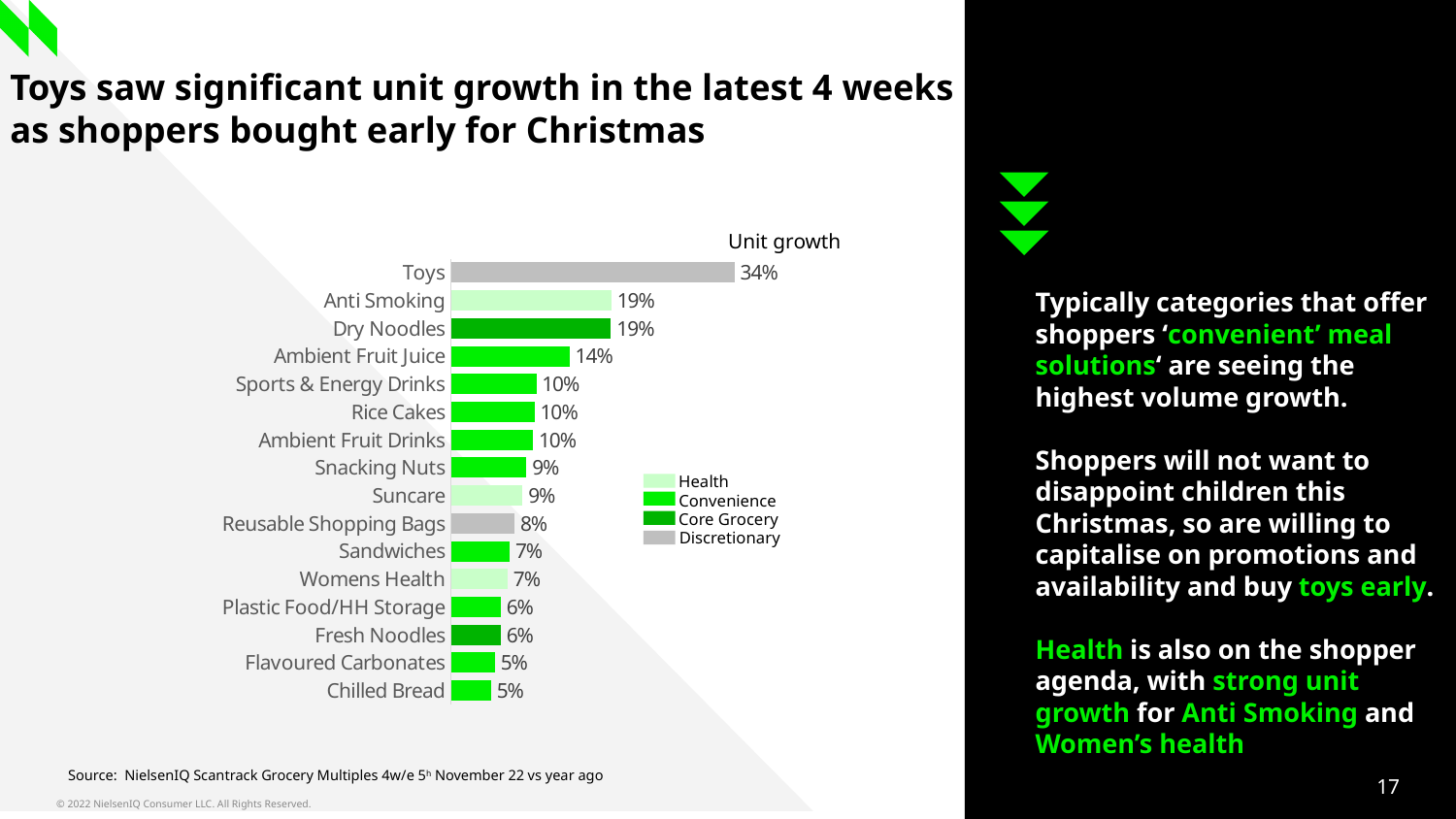
What is the unit growth for Reusable Shopping Bags? 8% Which category has the highest unit growth? Toys How many categories are shown in the chart? 16 What is the difference in unit growth between Toys and Dry Noodles? 15% What is the unit growth for Toys? 34% What is the unit growth for Chilled Bread? 5% What is the title of the chart? Unit growth What is the unit growth for Ambient Fruit Juice? 14% What type of chart is shown on the slide? Bar chart How many entries does the legend list? 4 Which has higher unit growth, Snacking Nuts or Sandwiches? Snacking Nuts Which legend group does the Toys bar belong to? Discretionary